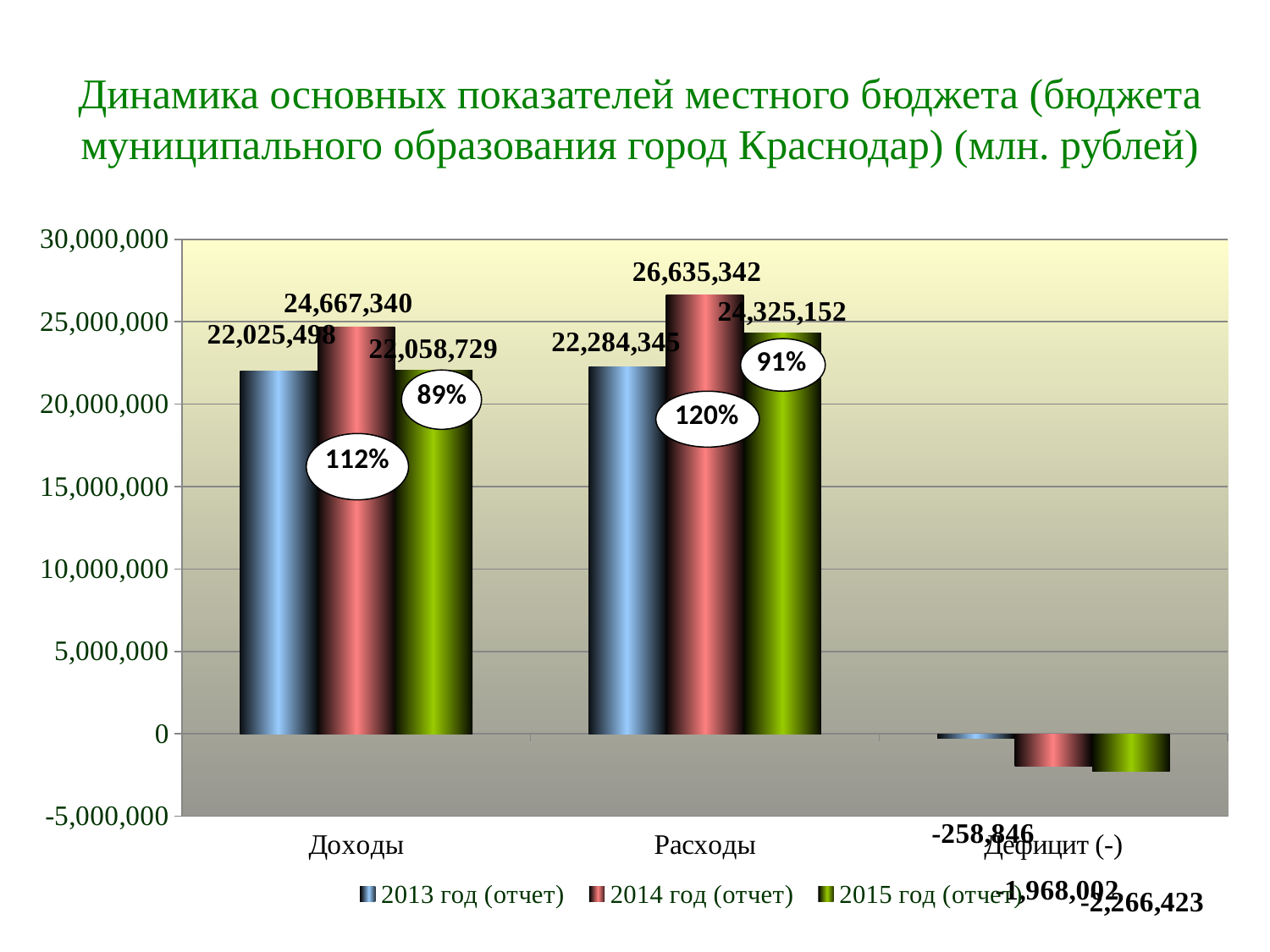
Which series has the lowest value for Доходы? 2013 год (отчет) What is the value for Расходы in the 2015 год (отчет) series? 24,325,152 How many series does the legend list? 3 What is the value for Расходы in the 2013 год (отчет) series? 22,284,345 Which is larger: the 2015 год (отчет) value for Доходы or the 2015 год (отчет) value for Расходы? Расходы Is the 2014 год (отчет) value for Расходы greater or less than 25,000,000? greater What is the value for Доходы in the 2014 год (отчет) series? 24,667,340 What is the value for Доходы in the 2013 год (отчет) series? 22,025,498 What kind of chart is shown on the slide? bar chart What is the difference between the 2014 год (отчет) and 2013 год (отчет) values for Расходы? 4,350,997 Which series has the highest value for Расходы? 2014 год (отчет) How many categories are shown on the x axis? 3